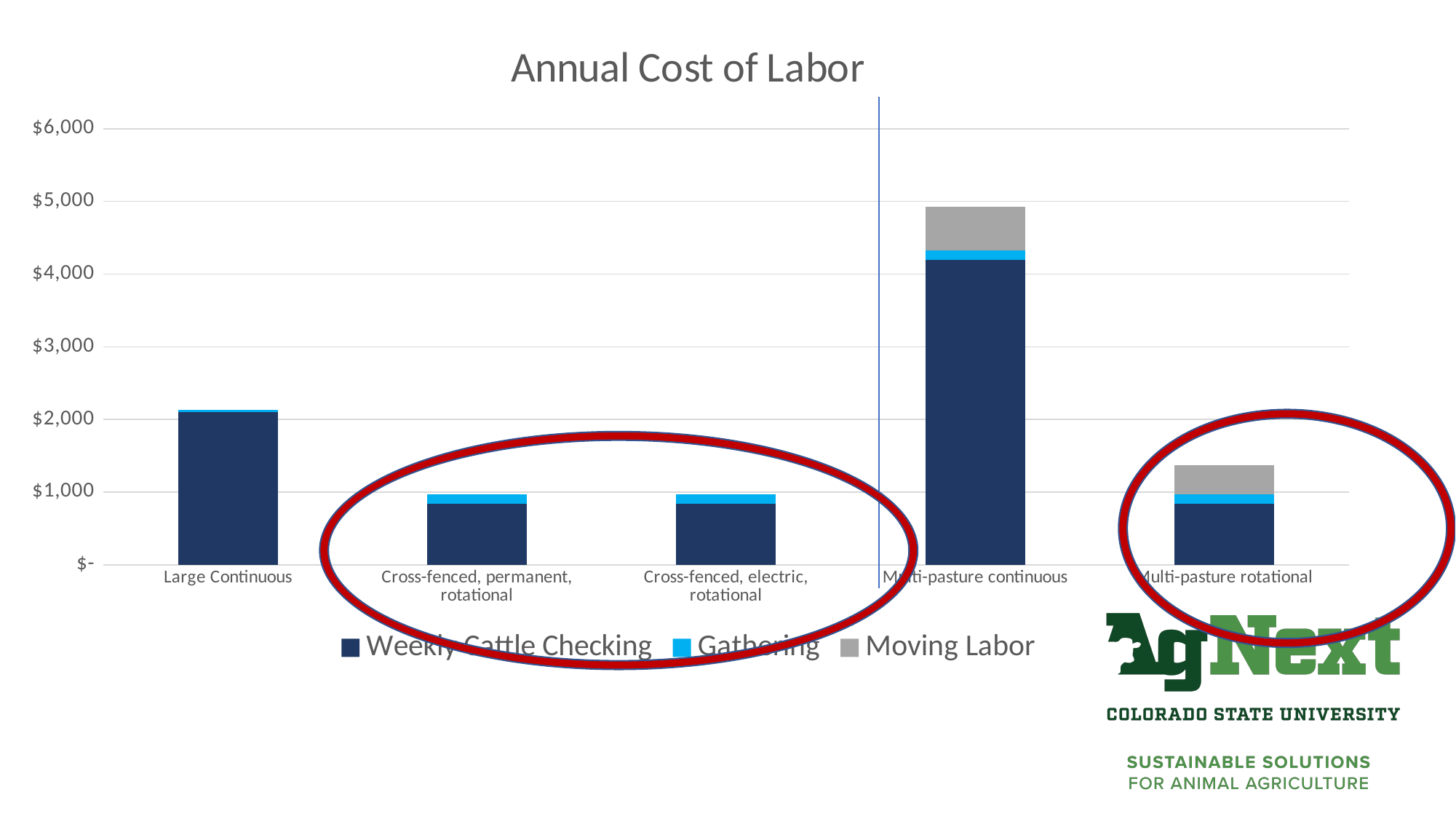
Is the total value for Multi-pasture continuous greater or less than $4,000? greater How many series does the legend list? 3 Which category has the highest total annual cost of labor? Multi-pasture continuous How many categories are shown on the x axis of the chart? 5 Which has a larger total annual cost of labor, Multi-pasture continuous or Multi-pasture rotational? Multi-pasture continuous Is the total value for Large Continuous greater or less than $2,000? greater What is the title of the chart? Annual Cost of Labor Which series is shown in grey in the legend? Moving Labor Is the total value for Multi-pasture rotational greater or less than $2,000? less What kind of chart is shown on the slide? stacked bar chart Which has a larger total annual cost of labor, Large Continuous or Multi-pasture rotational? Large Continuous